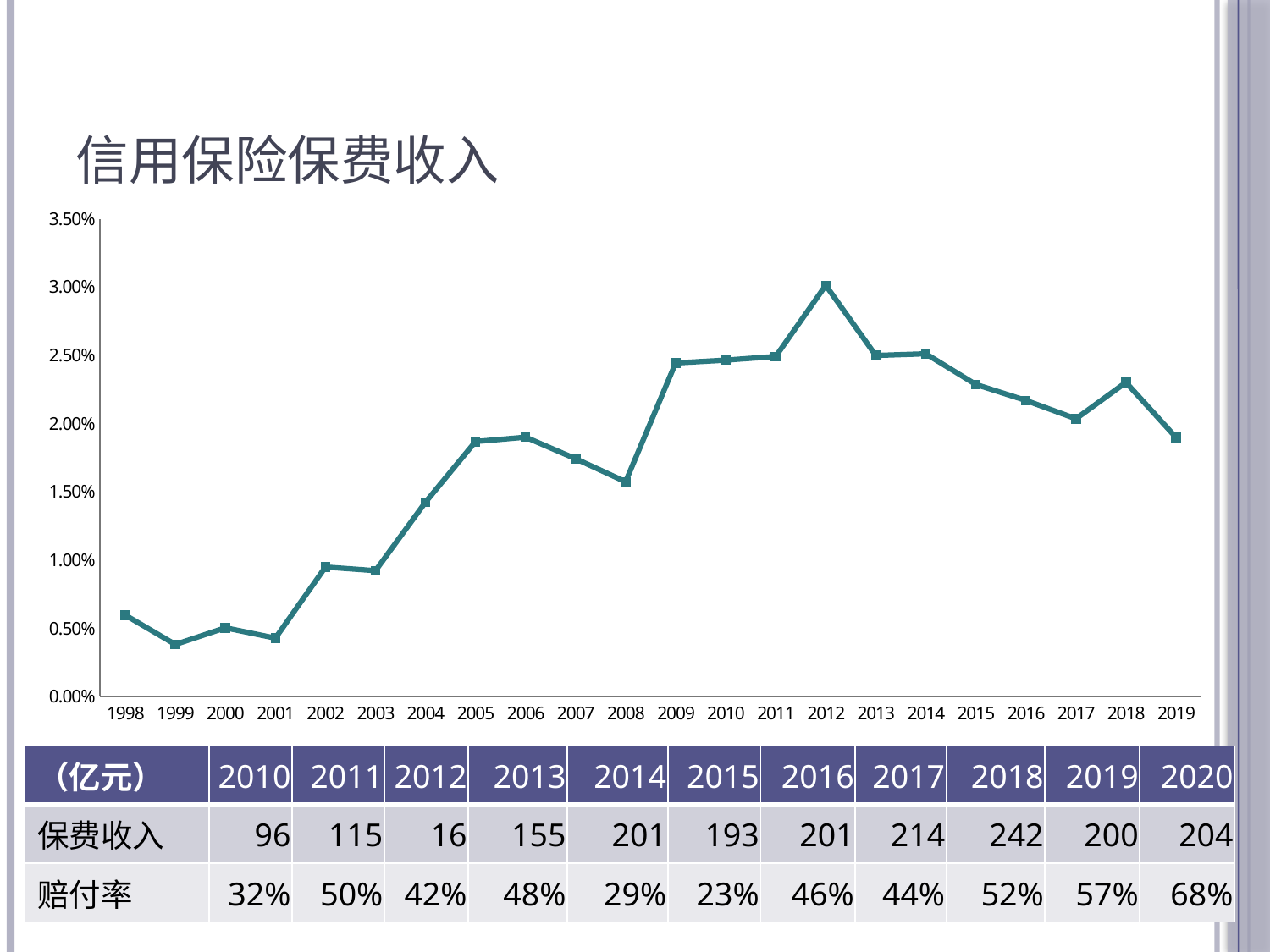
What kind of chart is shown on the slide? line chart Is the value for 2009 greater or less than 2.00%? greater Is the value for 2008 greater or less than 2.00%? less Which is larger, the value for 2012 or the value for 2013? 2012 Do the values rise or fall from 2001 to 2005? rise How many years are plotted on the x axis of the line chart? 22 Is the value for 2012 greater or less than 2.50%? greater Which year has the highest value on the line chart? 2012 What is the title of the chart? 信用保险保费收入 Which is larger, the value for 2001 or the value for 2002? 2002